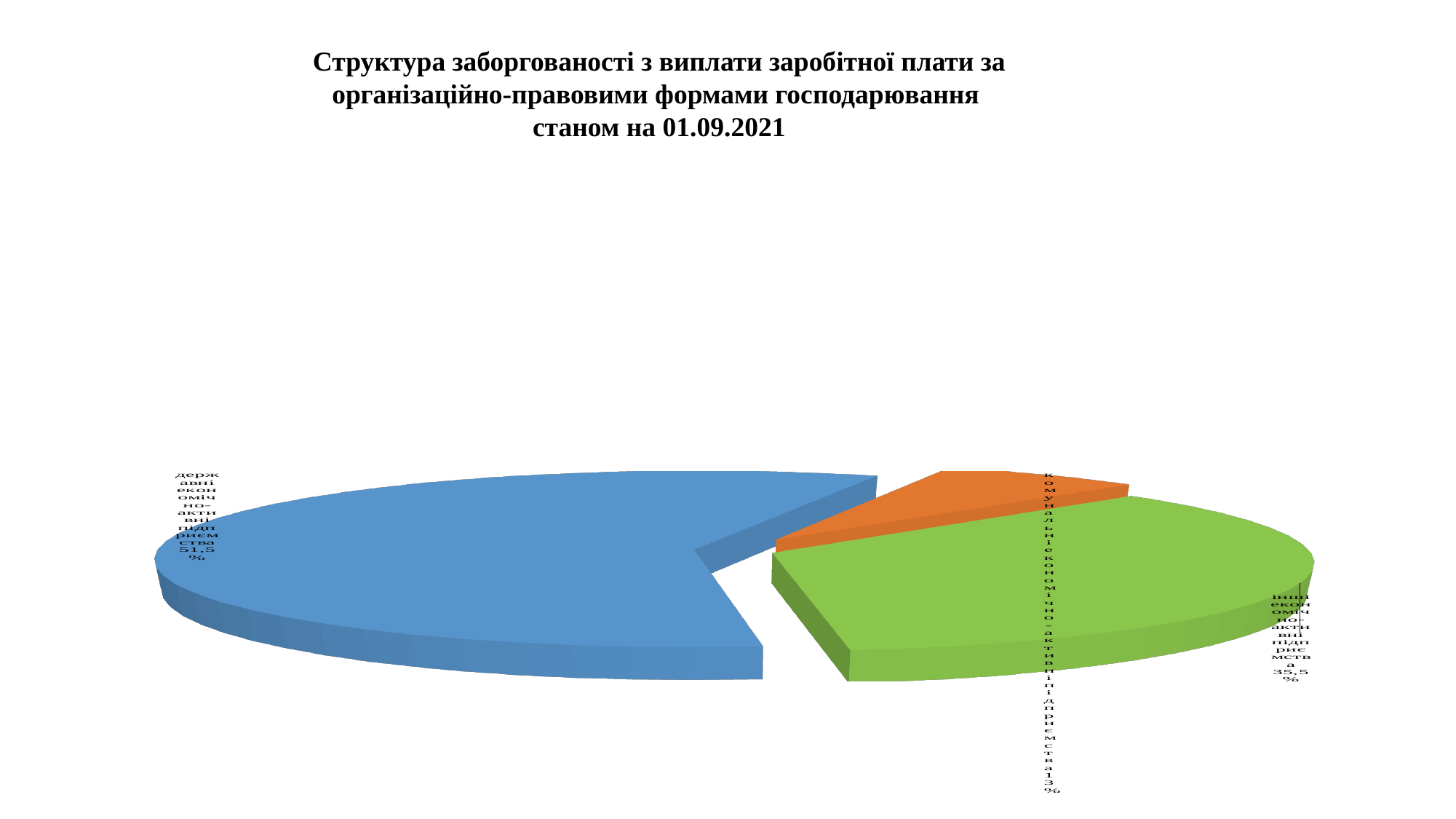
How many slices does the pie chart have? 3 Which category has the smallest slice of the pie? комунальні економічно-активні підприємства What share of the pie is labelled for комунальні економічно-активні підприємства? 13% By how many percentage points does the share for інші економічно-активні підприємства exceed the share for комунальні економічно-активні підприємства? 22,5 What colour is the slice for державні економічно-активні підприємства? blue What date is given in the chart title? 01.09.2021 What share of the pie is labelled for державні економічно-активні підприємства? 51,5% By how many percentage points does the share for державні економічно-активні підприємства exceed the share for інші економічно-активні підприємства? 16 Which category has the largest slice of the pie? державні економічно-активні підприємства Which is larger: the share for інші економічно-активні підприємства or for комунальні економічно-активні підприємства? інші економічно-активні підприємства What kind of chart is shown on the slide? pie chart What share of the pie is labelled for інші економічно-активні підприємства? 35,5%